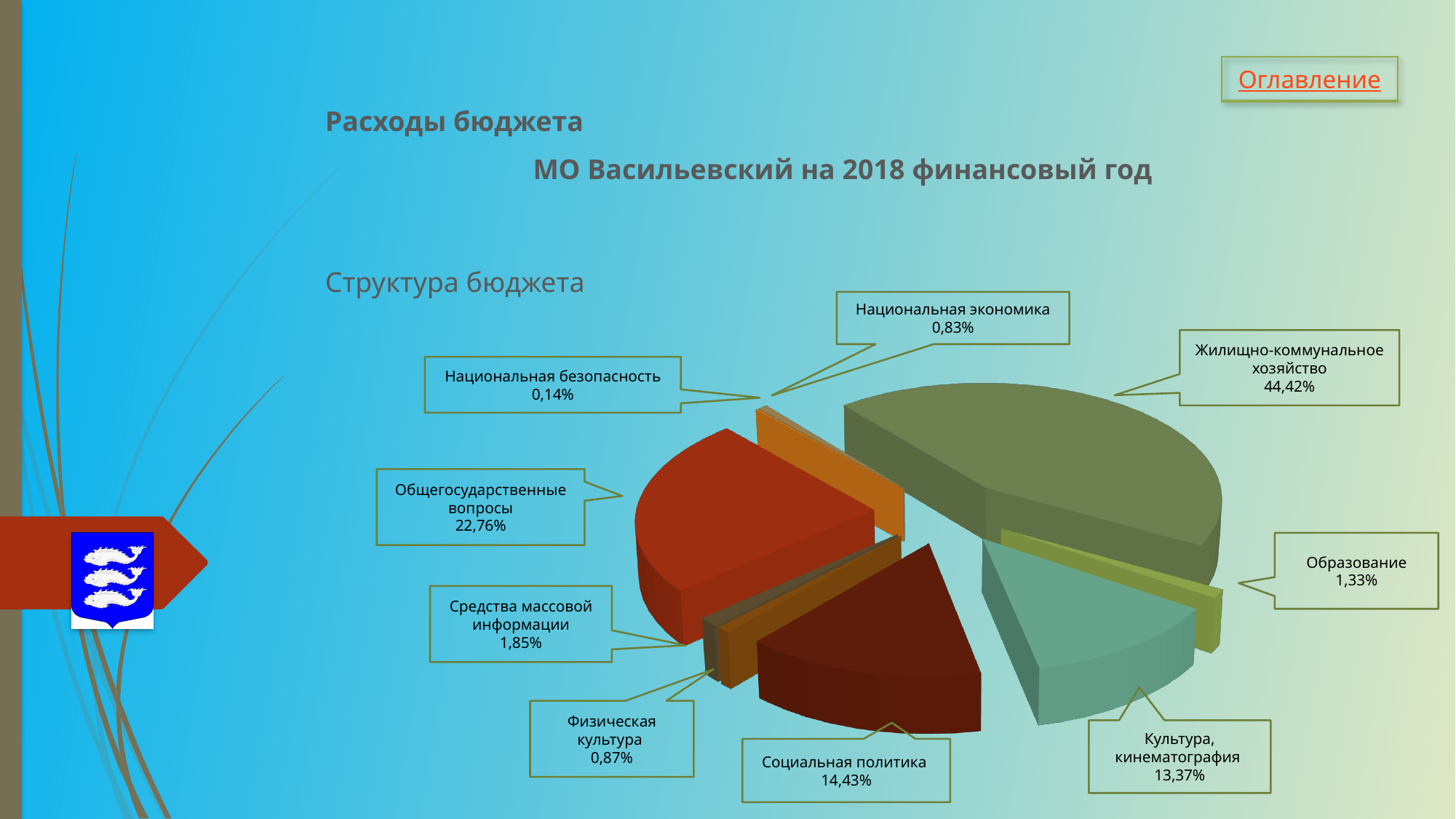
What is the value shown for Социальная политика? 14,43% What is the value shown for Национальная безопасность? 0,14% What is the difference between the values for Социальная политика and Культура, кинематография? 1,06% Which is larger, the value for Средства массовой информации or the value for Образование? Средства массовой информации Which category has the largest slice of the pie? Жилищно-коммунальное хозяйство What is the value shown for Образование? 1,33% How many categories are shown in the pie chart? 9 What kind of chart is shown on the slide? Pie chart What share of the pie does Жилищно-коммунальное хозяйство account for? 44,42% What is the value shown for Общегосударственные вопросы? 22,76% Which category has the smallest slice of the pie? Национальная безопасность What is the difference between the values for Жилищно-коммунальное хозяйство and Общегосударственные вопросы? 21,66%